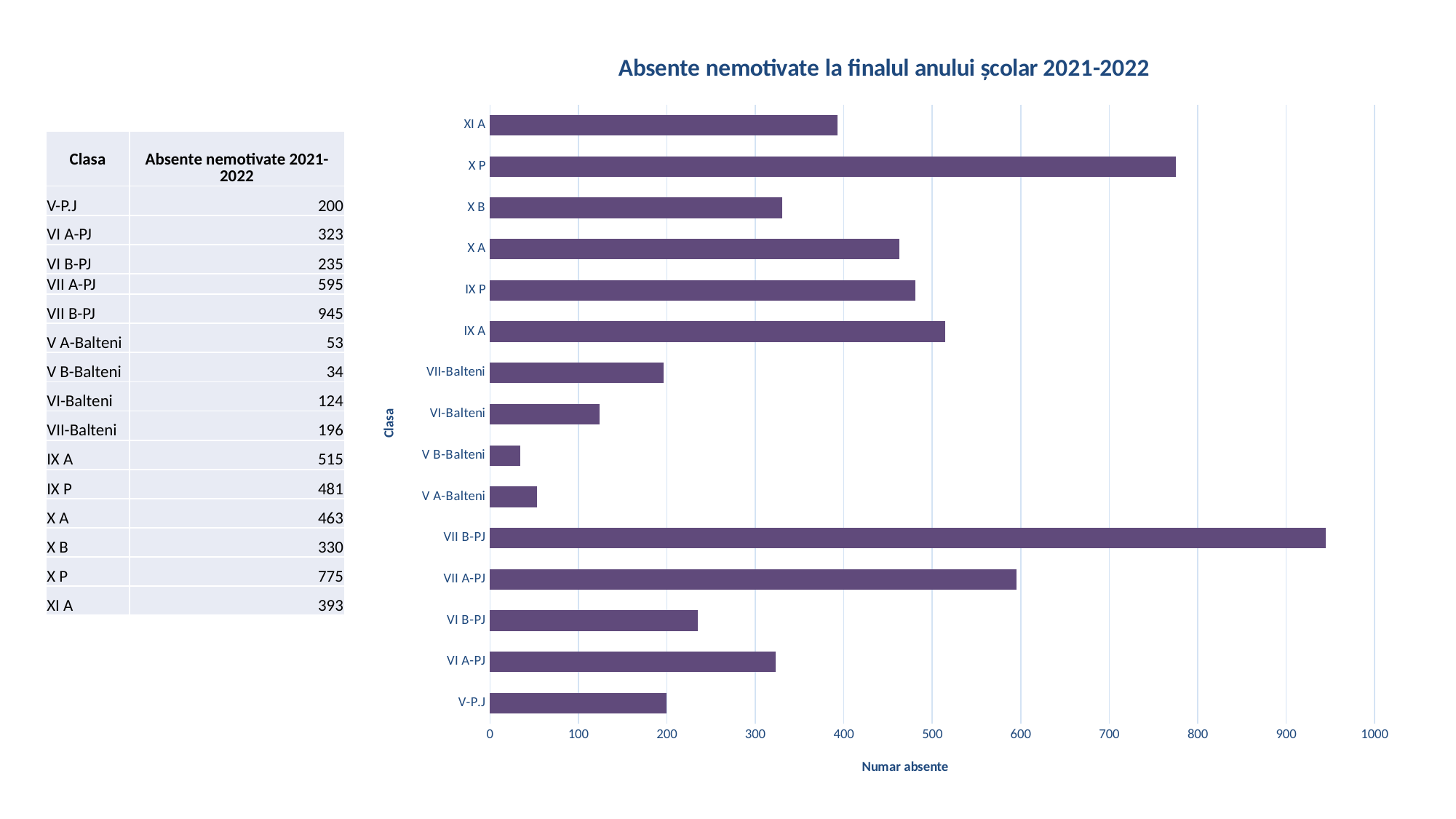
What kind of chart is shown on the slide? bar chart What is the title of the chart? Absente nemotivate la finalul anului școlar 2021-2022 What is the number of unmotivated absences for class VI-Balteni? 124 Is the value for X A greater or less than 400? greater Which class has the highest number of unmotivated absences? VII B-PJ How many classes (categories) are plotted in the chart? 15 What is the label of the horizontal axis of the chart? Numar absente What is the number of unmotivated absences for class X P? 775 What is the number of unmotivated absences for class IX A? 515 Which class has the lowest number of unmotivated absences? V B-Balteni Which class has more unmotivated absences, IX A or IX P? IX A What is the difference in unmotivated absences between X P and XI A? 382